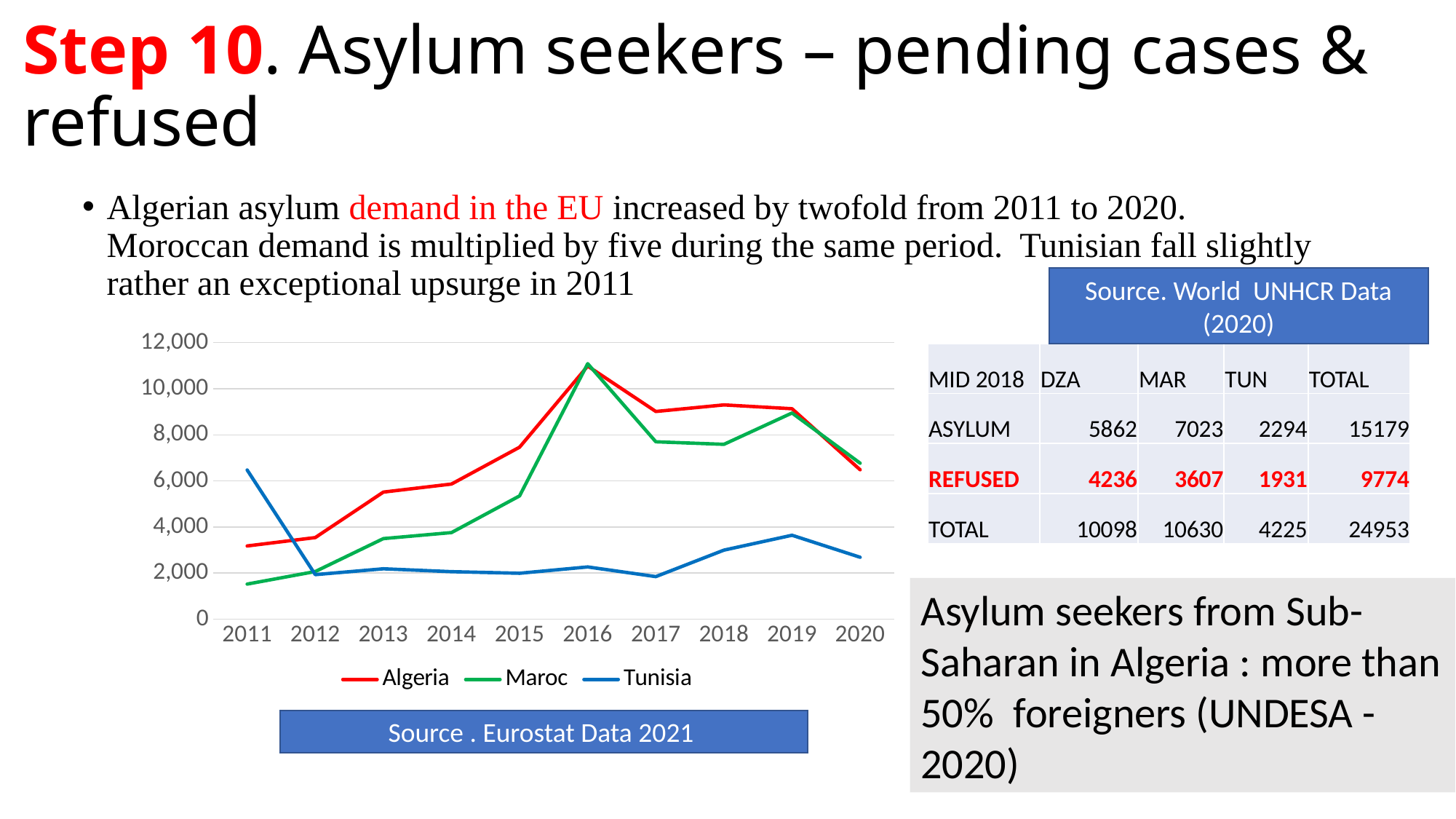
Is the value for Maroc in 2019 greater or less than 8,000? greater How many series does the chart legend list? 3 In 2015, which series has the larger value, Algeria or Maroc? Algeria In which year does the Algeria series reach its highest value? 2016 Which series has the lowest value in 2020? Tunisia How many years are shown on the x axis of the chart? 10 Is the value for Maroc in 2011 greater or less than 2,000? less In 2011, which series has the larger value, Algeria or Tunisia? Tunisia Does the Maroc series rise or fall from 2011 to 2016? rise What kind of chart is shown on the slide? line chart Is the value for Algeria in 2016 greater or less than 10,000? greater